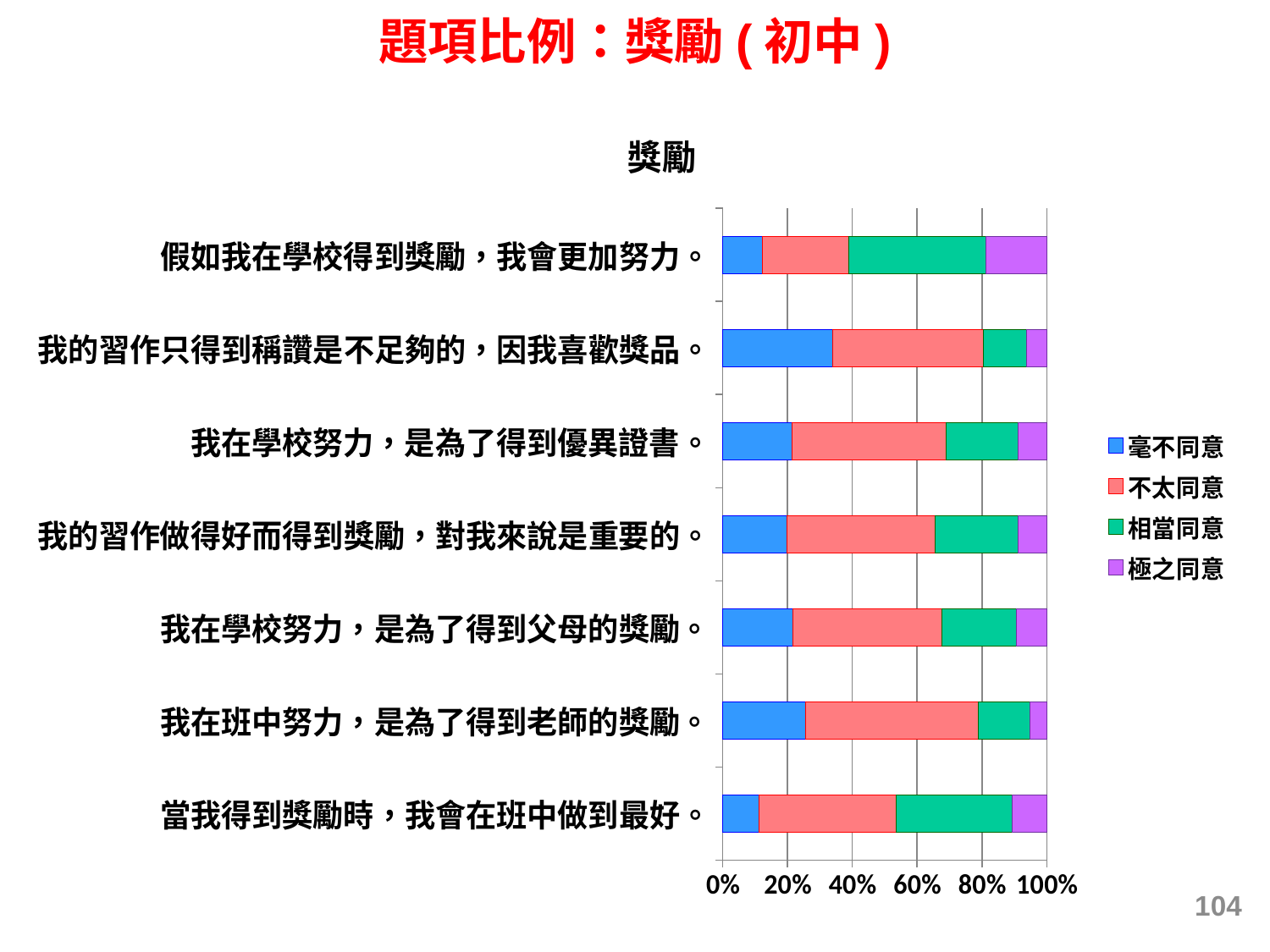
Which has the larger 相當同意 share: 假如我在學校得到獎勵，我會更加努力。 or 我的習作只得到稱讚是不足夠的，因我喜歡獎品。? 假如我在學校得到獎勵，我會更加努力。 Which statement has the largest 極之同意 share? 假如我在學校得到獎勵，我會更加努力。 Which legend entry is shown in purple? 極之同意 Which statement has the largest 毫不同意 share? 我的習作只得到稱讚是不足夠的，因我喜歡獎品。 How many series does the legend list? 4 Is the 毫不同意 share for 我的習作只得到稱讚是不足夠的，因我喜歡獎品。 greater or less than 20%? greater What kind of chart is shown on the slide? Stacked bar chart What is the title of the chart? 獎勵 Which has the larger 毫不同意 share: 我的習作只得到稱讚是不足夠的，因我喜歡獎品。 or 當我得到獎勵時，我會在班中做到最好。? 我的習作只得到稱讚是不足夠的，因我喜歡獎品。 Is the 毫不同意 share for 假如我在學校得到獎勵，我會更加努力。 greater or less than 20%? less How many statements (categories) are plotted in the chart? 7 Which statement has the largest 相當同意 share? 假如我在學校得到獎勵，我會更加努力。